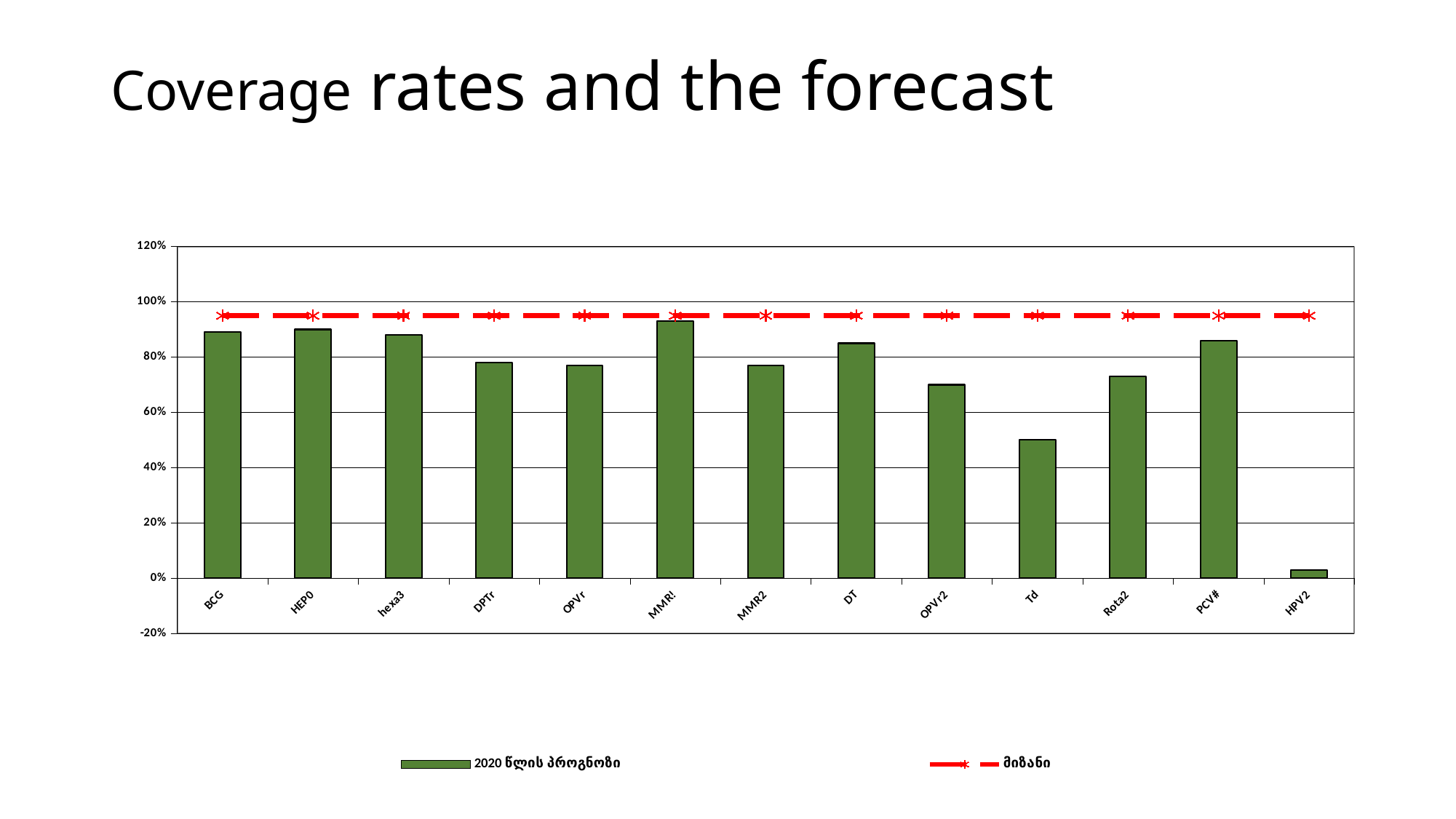
Is the value for BCG greater or less than 80%? greater Which is larger, the value for DT or the value for OPVr2? DT Is the value for Td greater or less than 60%? less What is the title of the slide containing the chart? Coverage rates and the forecast What colour are the bars in the chart? green Which is larger, the value for Rota2 or the value for Td? Rota2 Is the value for OPVr2 greater or less than 60%? greater How many series does the chart's legend list? 2 How many categories are shown on the x axis of the chart? 13 What kind of chart is shown on the slide? bar chart Which category has the lowest bar in the chart? HPV2